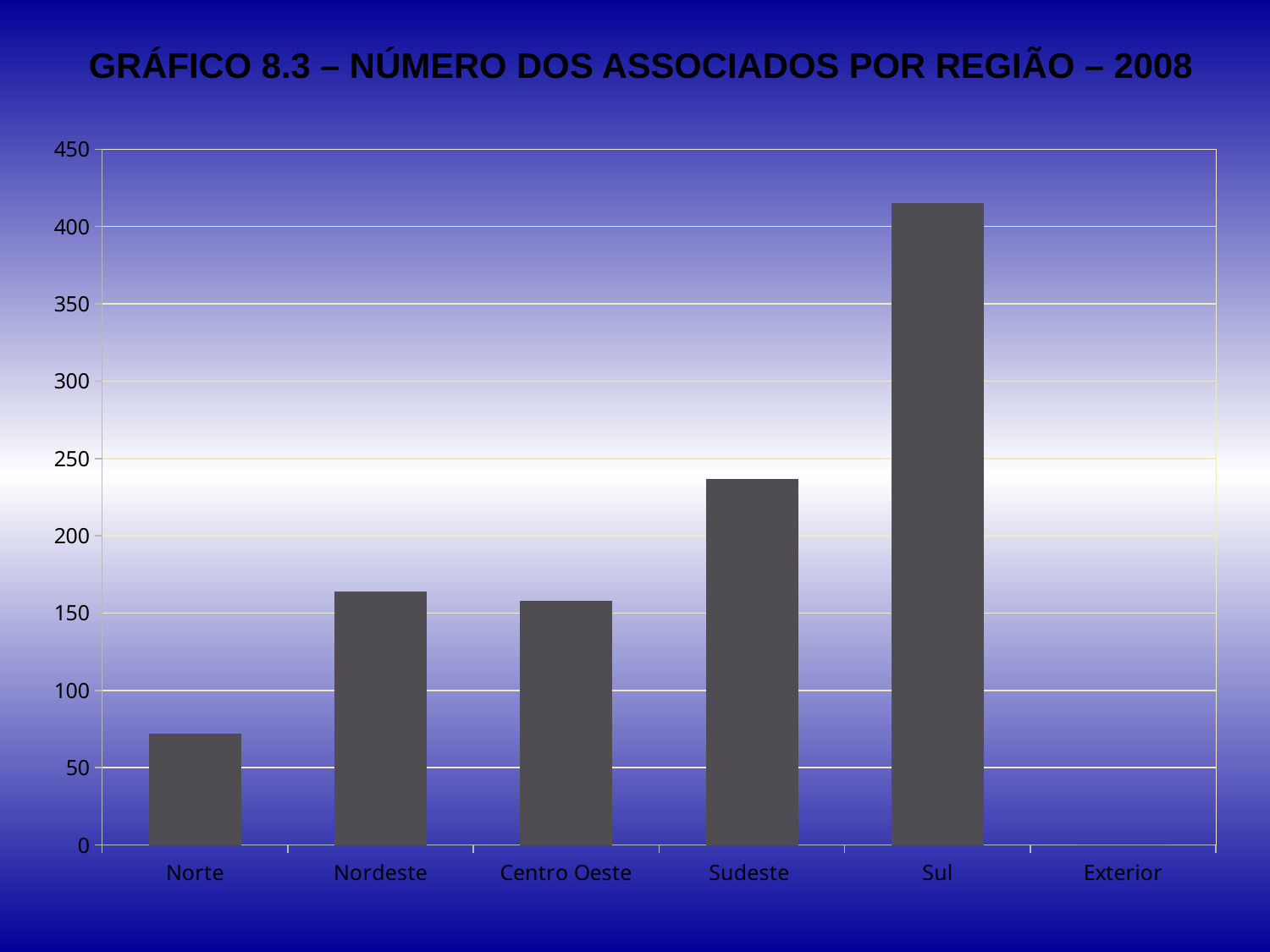
Is the value for Norte greater or less than 100? less Which region has the highest number of associates? Sul What is the title of the chart? GRÁFICO 8.3 – NÚMERO DOS ASSOCIADOS POR REGIÃO – 2008 Is the value for Nordeste greater or less than 150? greater Among the regions with a visible bar, which has the lowest number of associates? Norte Is the value for Sudeste greater or less than 250? less What kind of chart is shown on the slide? bar chart How many regions are shown on the x axis of the chart? 6 Which has more associates, Sul or Sudeste? Sul Which has more associates, Sudeste or Nordeste? Sudeste